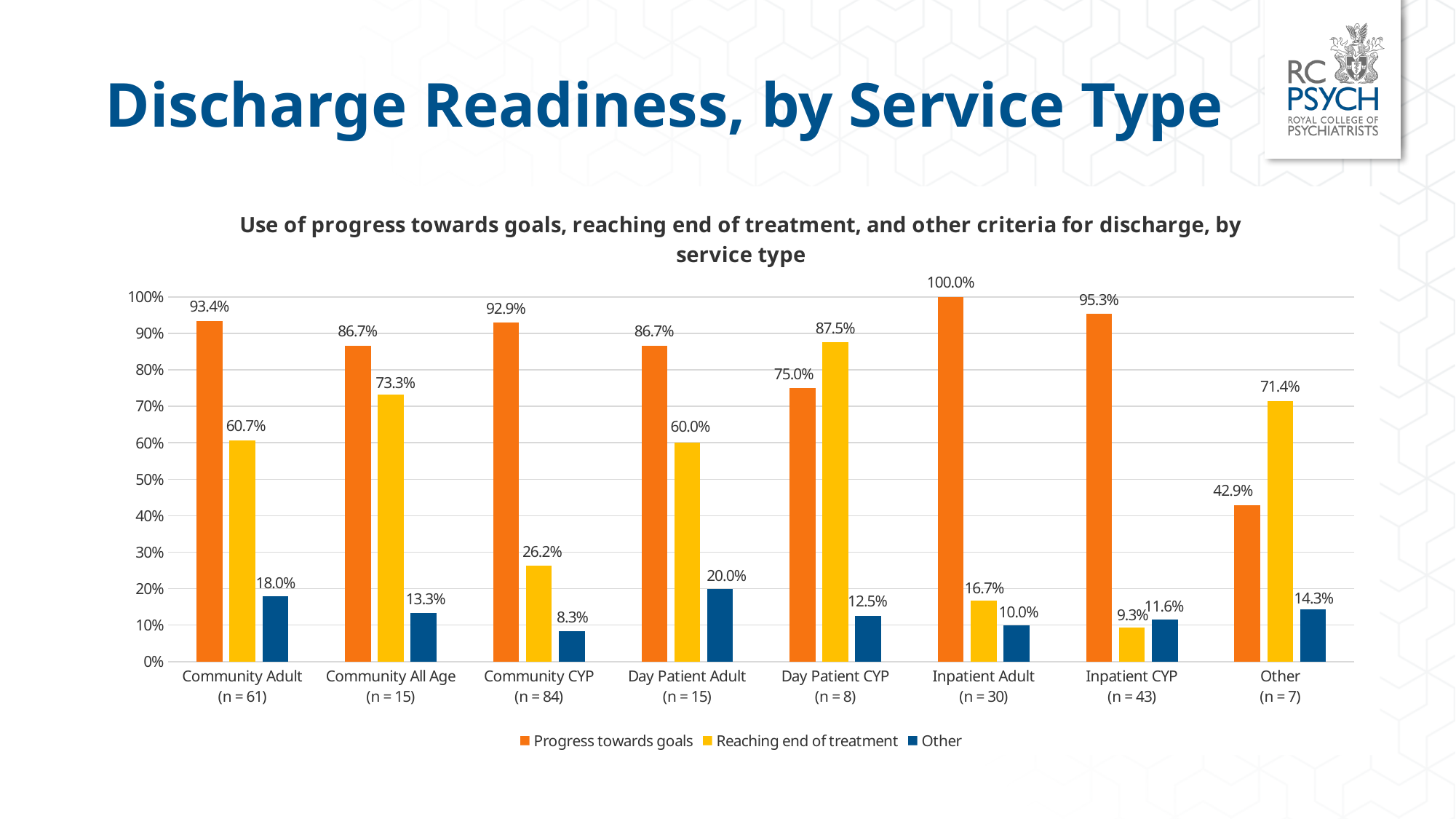
Is the value for Other for Day Patient Adult greater or less than 10%? greater What is the value for Other for Inpatient CYP? 11.6% What is the sample size (n) shown for Community CYP? 84 How many service types are shown on the x axis? 8 What kind of chart is shown on the slide? Bar chart Which is larger for Day Patient CYP: Progress towards goals or Reaching end of treatment? Reaching end of treatment What is the value for Progress towards goals for Community Adult? 93.4% What is the difference between Progress towards goals and Reaching end of treatment for Community CYP? 66.7% Which service type has the highest value for Progress towards goals? Inpatient Adult What is the value for Reaching end of treatment for Day Patient CYP? 87.5% How many series does the legend list? 3 Which service type has the lowest value for Reaching end of treatment? Inpatient CYP